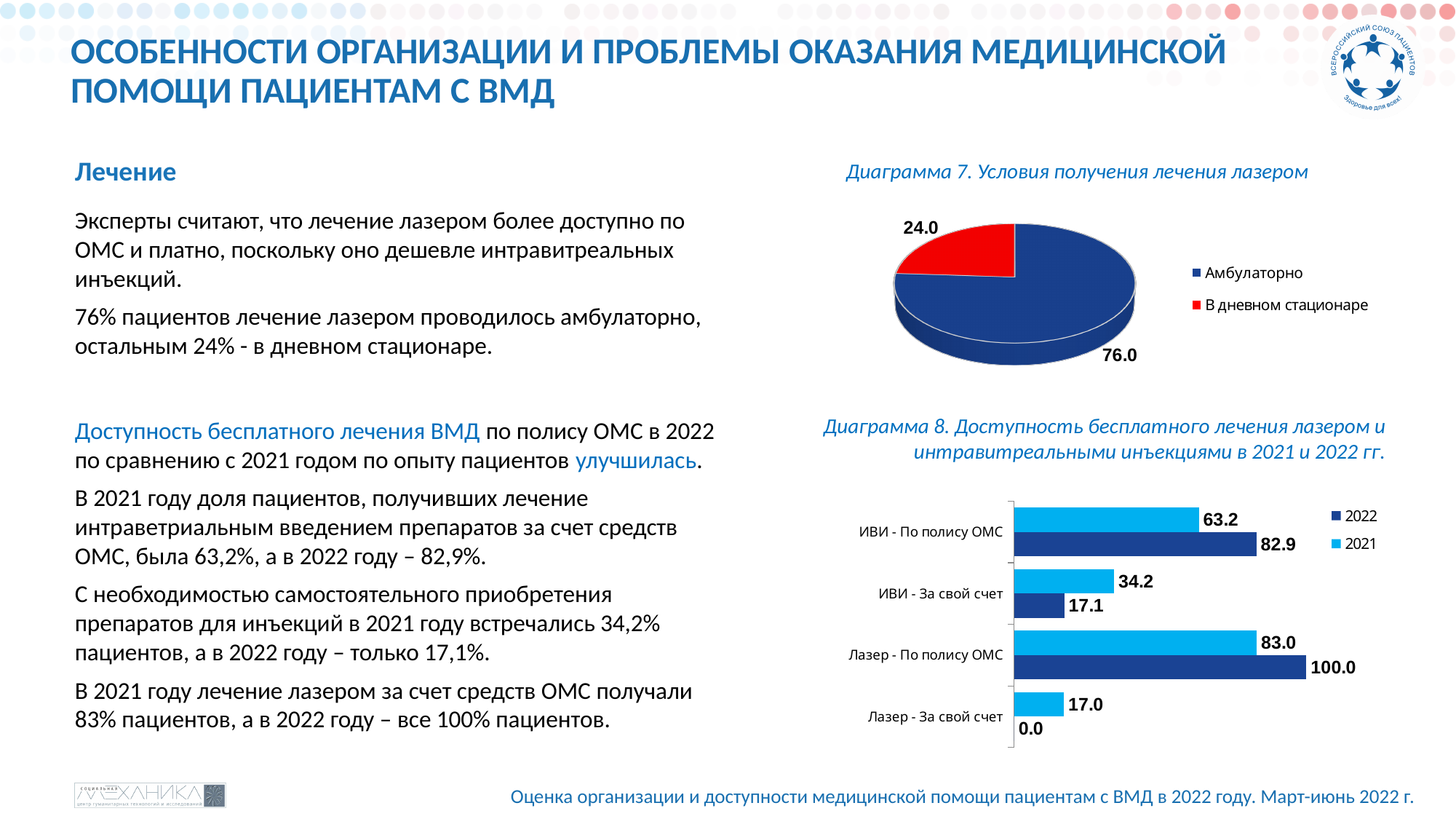
In Диаграмма 8, which category has the highest 2022 value? Лазер - По полису ОМС In Диаграмма 8, how many categories are shown? 4 In Диаграмма 7, what is the value for Амбулаторно? 76.0 What kind of chart is Диаграмма 8? Bar chart In Диаграмма 7, which slice is the largest? Амбулаторно In Диаграмма 8, what is the 2021 value for ИВИ - За свой счет? 34.2 In Диаграмма 8, what is the 2022 value for ИВИ - По полису ОМС? 82.9 In Диаграмма 8, how many series does the legend list? 2 In Диаграмма 7, what is the value for В дневном стационаре? 24.0 What kind of chart is Диаграмма 7? Pie chart In Диаграмма 8, what is the 2022 value for Лазер - За свой счет? 0.0 In Диаграмма 8, what is the difference between the 2022 and 2021 values for ИВИ - По полису ОМС? 19.7